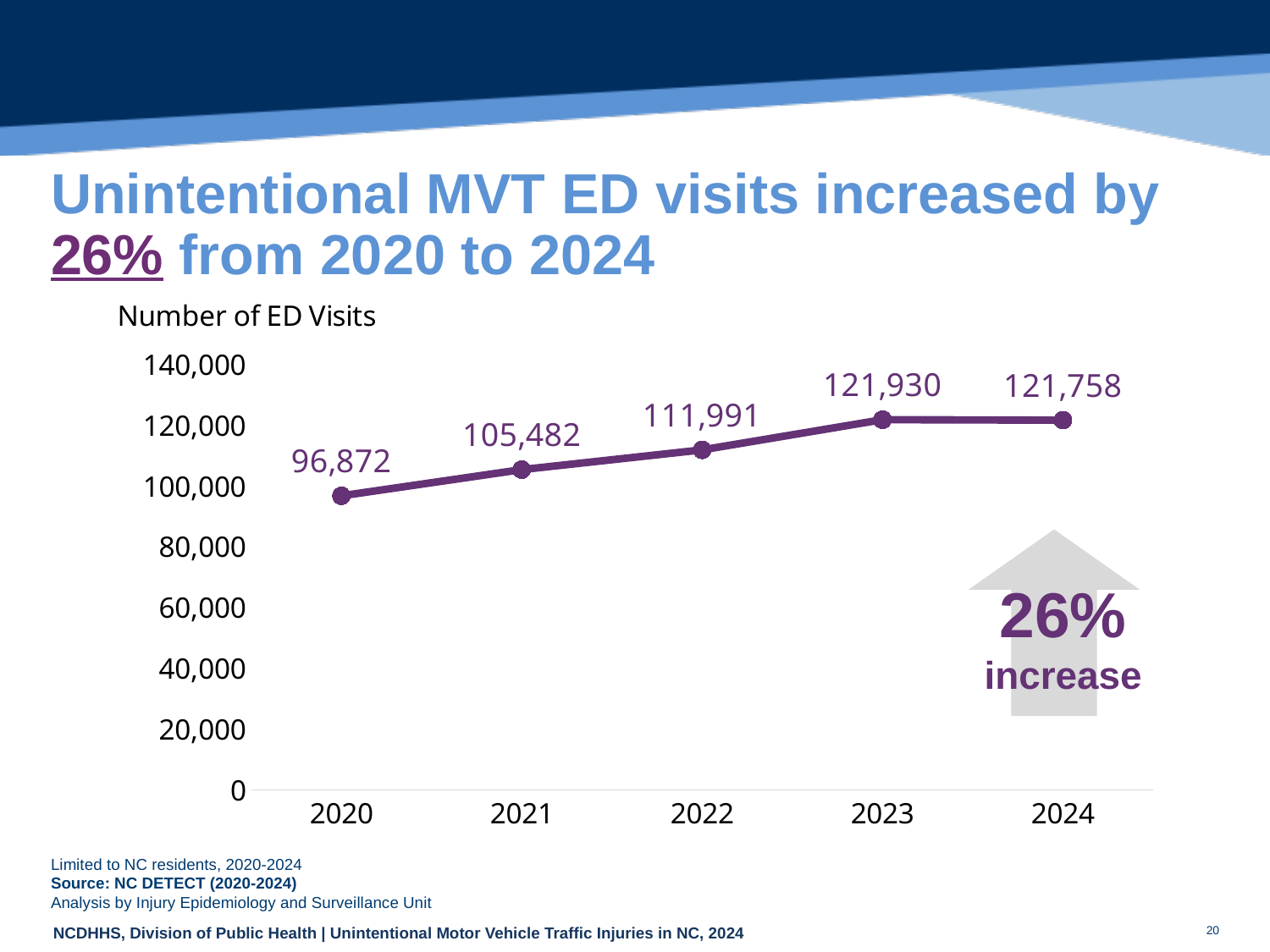
What is the difference in ED visits between 2023 and 2024? 172 Which year has the lowest number of ED visits? 2020 What kind of chart is shown on the slide? Line chart Do the number of ED visits generally rise or fall from 2020 to 2024? Rise Which year has the highest number of ED visits? 2023 Which year has more ED visits, 2021 or 2022? 2022 What is the number of ED visits in 2024? 121,758 What is the difference in ED visits between 2021 and 2020? 8,610 How many years are plotted on the chart? 5 Is the value for 2023 greater or less than 120,000? greater What is the number of ED visits in 2020? 96,872 What is the number of ED visits in 2022? 111,991